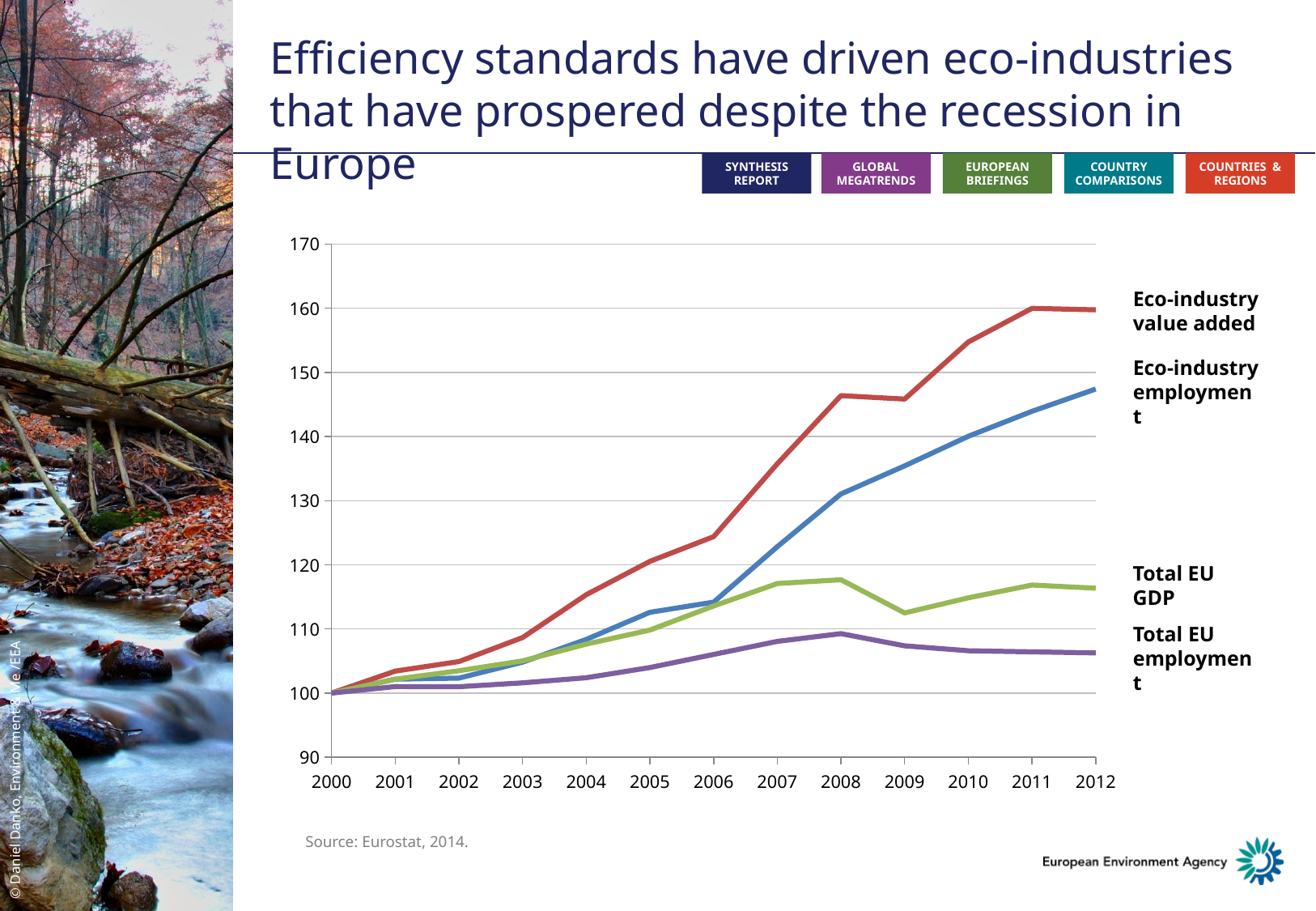
Is the value for Total EU GDP in 2008 greater or less than 120? less Is the value for Eco-industry employment in 2012 greater or less than 140? greater How many years are plotted along the x axis? 13 What is the source cited below the chart? Eurostat, 2014 Which series has the lowest value in 2012? Total EU employment Does Eco-industry value added generally rise or fall from 2000 to 2012? rise Which series has the highest value in 2012? Eco-industry value added Is the value for Eco-industry value added in 2008 greater or less than 140? greater In 2012, which is larger: Eco-industry employment or Total EU GDP? Eco-industry employment What is the value of Eco-industry value added in 2000? 100 How many series does the chart show? 4 What kind of chart is shown on the slide? line chart